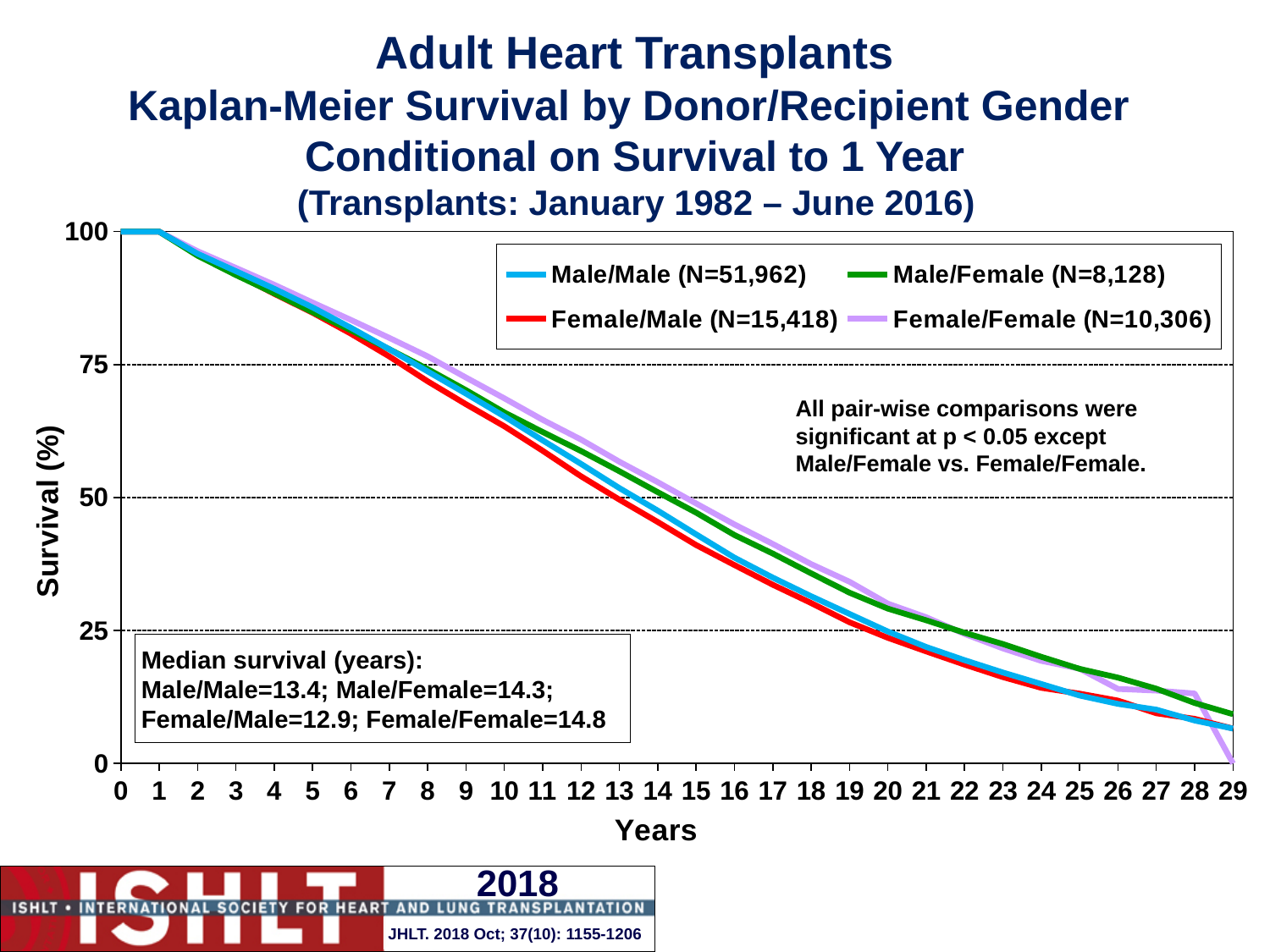
What is the difference in median survival (years) between the Female/Female and Female/Male groups? 1.9 Is the survival value for the Male/Female group at 25 years greater or less than 25? less Which donor/recipient gender group has the smallest N in the legend? Male/Female Is the survival value for the Female/Male group at 10 years greater or less than 50? greater What is the median survival in years for the Female/Male group? 12.9 What is the median survival in years for the Female/Female group? 14.8 Do the survival curves rise or fall as years increase? fall What kind of chart is shown on the slide? line chart What is the N for the Male/Male group shown in the legend? 51,962 What is the N for the Female/Female group shown in the legend? 10,306 How many series does the legend list? 4 Which donor/recipient gender group has the largest N in the legend? Male/Male